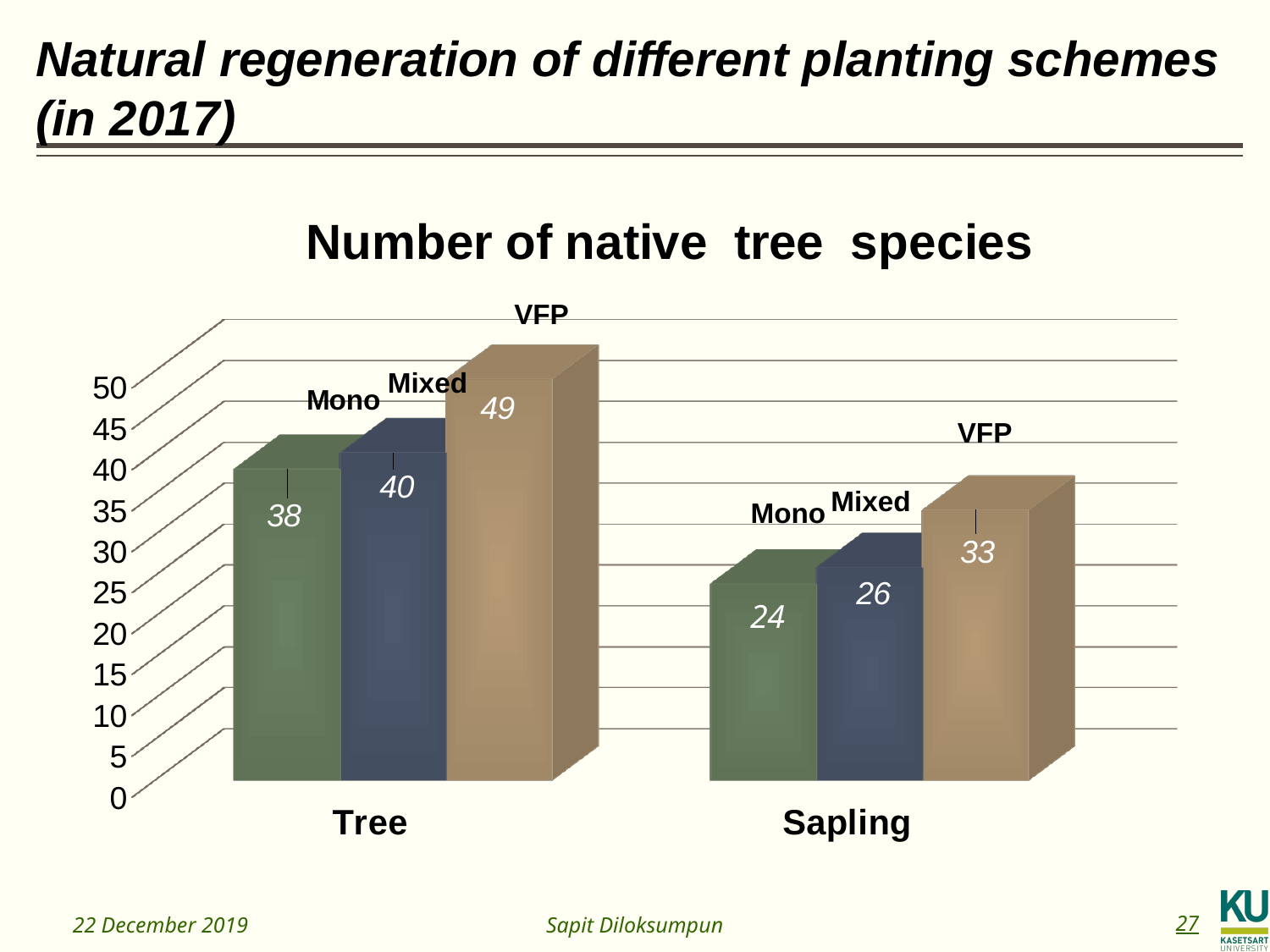
What is the difference between the VFP and Mono values in the Tree category? 11 What is the title of the chart? Number of native tree species How many planting schemes (series) are plotted for each category? 3 Which planting scheme has the highest value in the Tree category? VFP What is the difference between the Mixed values for Tree and Sapling? 14 How many categories are shown on the x axis? 2 Which is larger: the VFP value for Sapling or the Mono value for Tree? Mono value for Tree What kind of chart is shown on the slide? Bar chart Which planting scheme has the lowest value in the Sapling category? Mono What is the value for Mixed in the Tree category? 40 What is the number of native tree species for Mono in the Tree category? 38 What is the number of native tree species for VFP in the Sapling category? 33